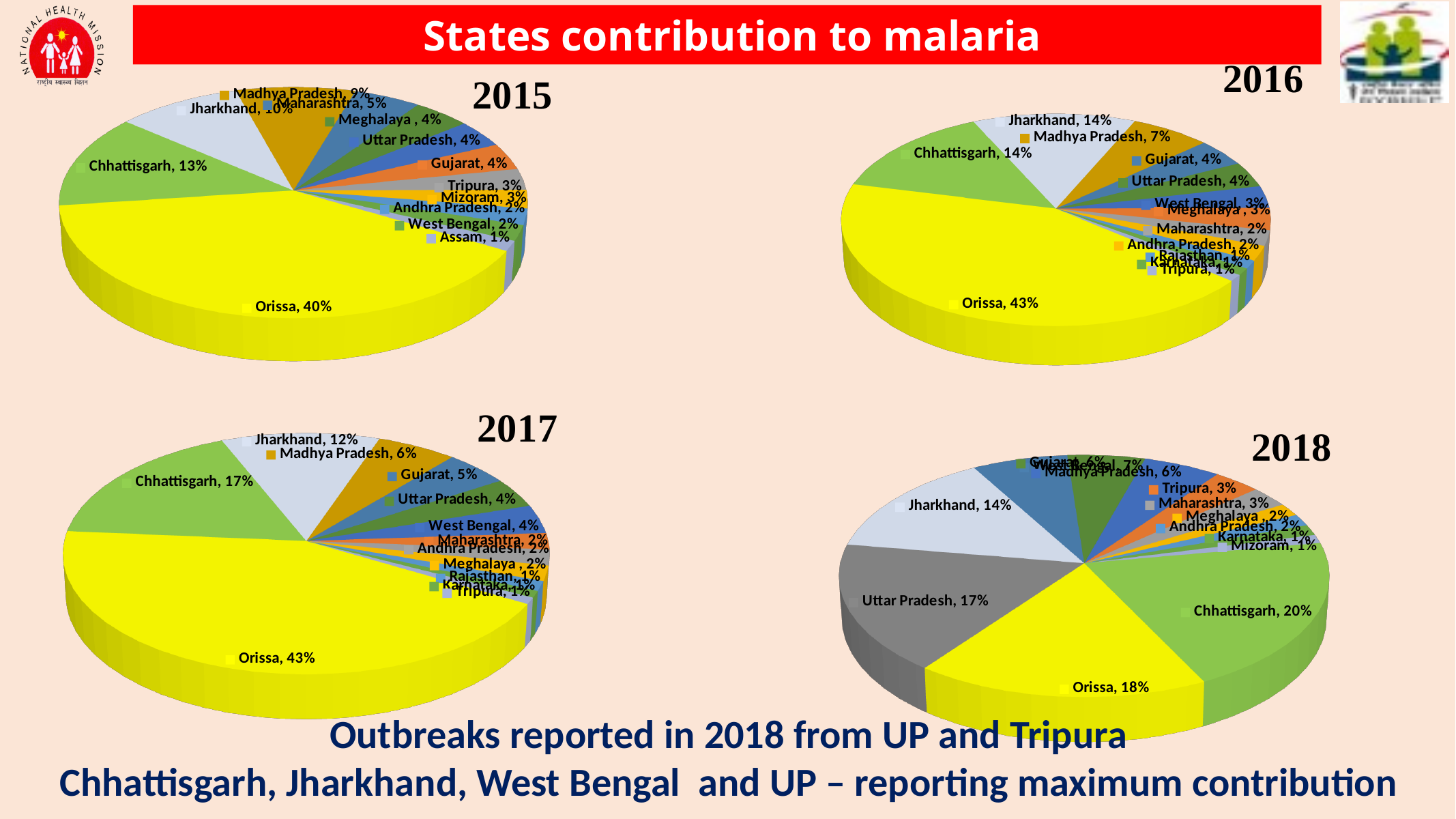
In the 2018 chart, what is the value for Uttar Pradesh? 17% In the 2018 chart, what is the difference between the shares of Chhattisgarh and Orissa? 2% In the 2018 chart, which state has the largest share? Chhattisgarh In the 2017 chart, what is the difference between the shares of Orissa and Chhattisgarh? 26% In the 2015 chart, what share of malaria contribution is attributed to Orissa? 40% In the 2016 chart, what is the value for Madhya Pradesh? 7% In the 2015 chart, what is the value for Chhattisgarh? 13% In the 2017 chart, which is larger, the share of Jharkhand or the share of Madhya Pradesh? Jharkhand In the 2016 chart, which state has the largest share? Orissa What kind of chart is used for each year on this slide? Pie chart What is the title of the slide? States contribution to malaria How many pie charts are shown on the slide? 4